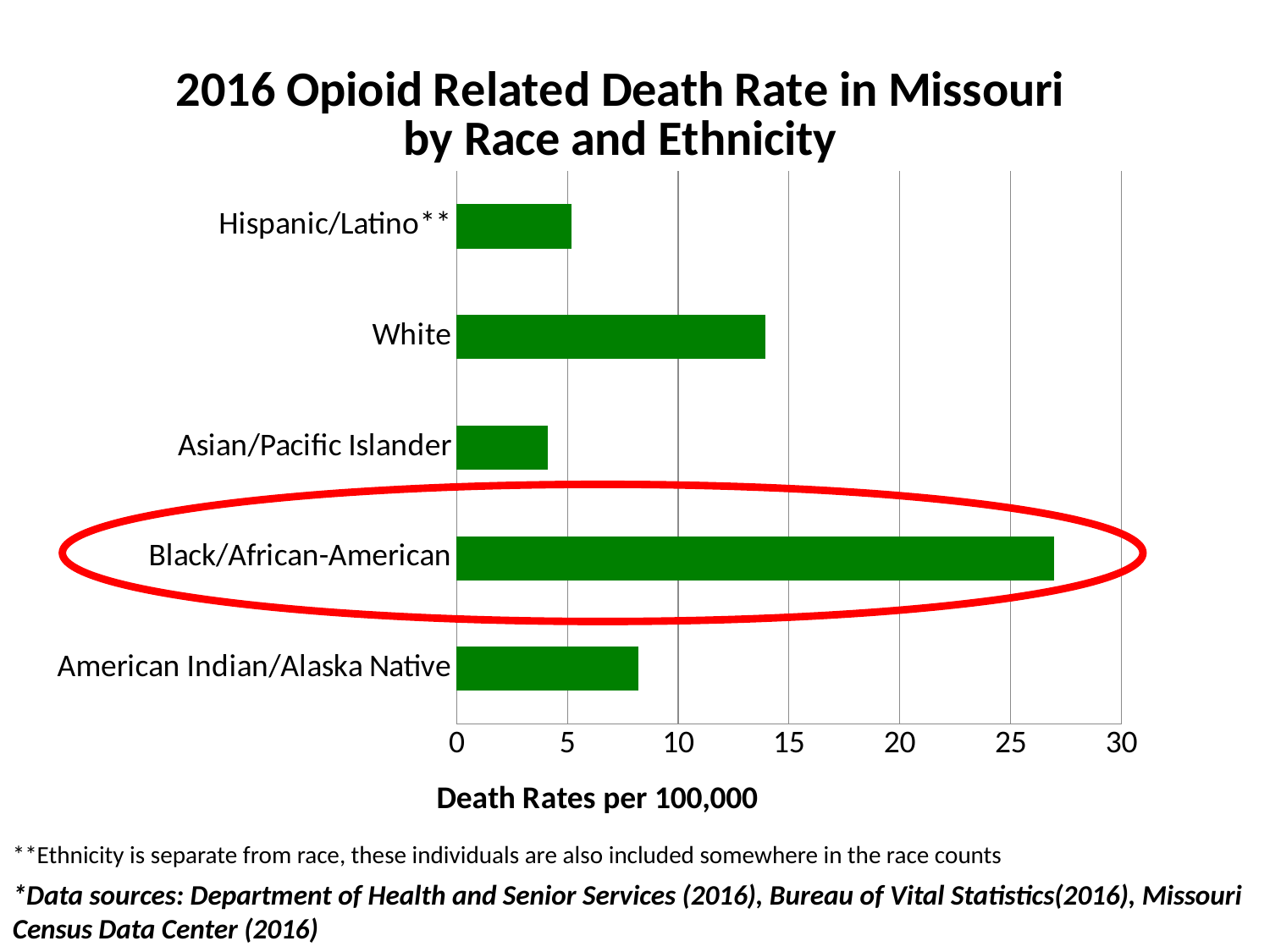
Is the death rate for White greater or less than 15? less Is the death rate for Black/African-American greater or less than 25? greater Is the death rate for White greater or less than 10? greater What is the label of the horizontal axis? Death Rates per 100,000 How many race/ethnicity categories are plotted in the chart? 5 Which category has the highest opioid related death rate? Black/African-American What is the title of the chart? 2016 Opioid Related Death Rate in Missouri by Race and Ethnicity Which has a higher death rate, White or American Indian/Alaska Native? White What kind of chart is shown on the slide? bar chart Which has a higher death rate, Hispanic/Latino or Asian/Pacific Islander? Hispanic/Latino